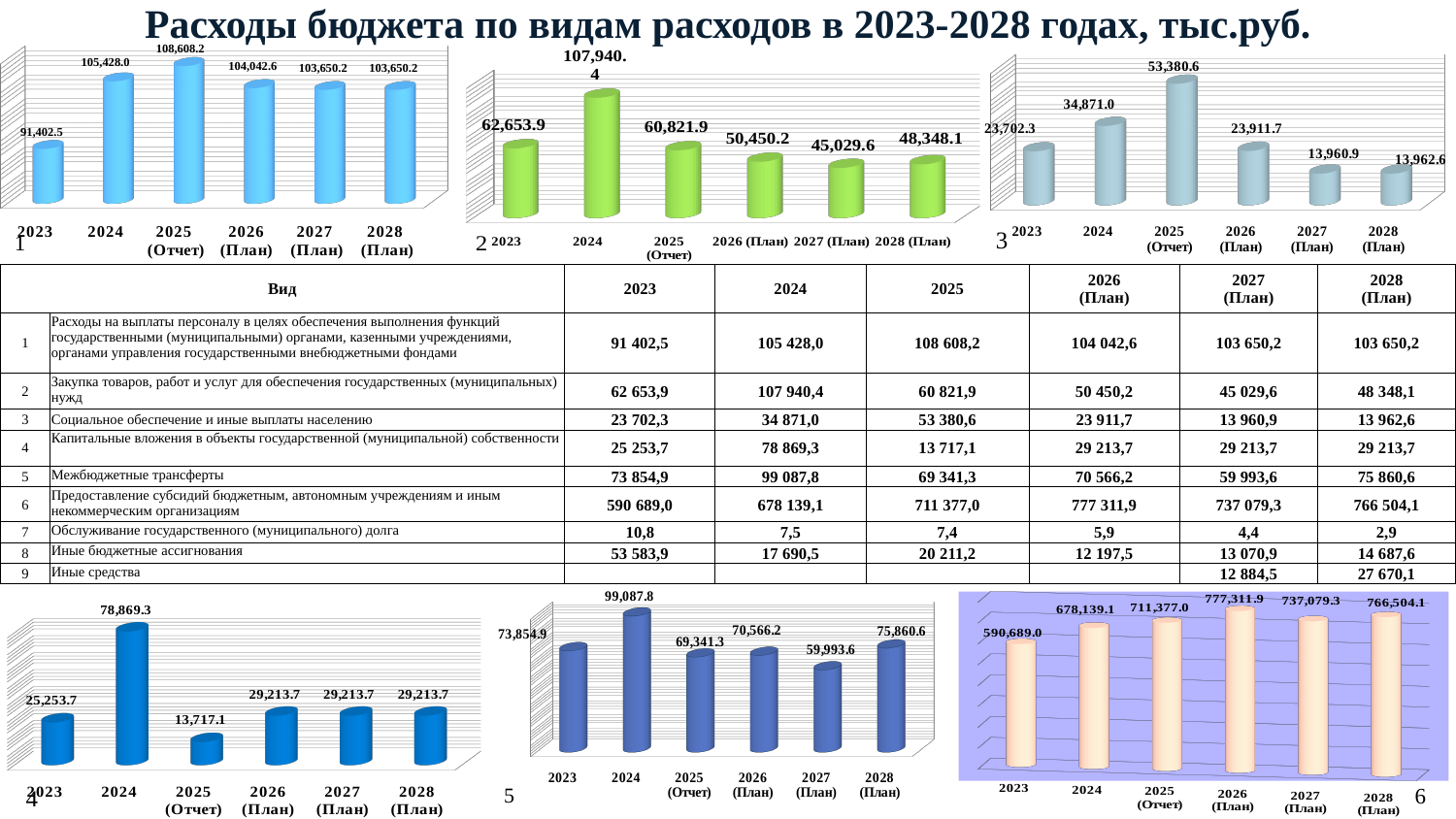
In chart 4 (bottom left), what is the value for 2025 (Отчет)? 13,717.1 How many bars does chart 3 (top right) have? 6 What type of chart is chart 5 (bottom middle)? Bar chart In chart 3 (top right), what is the difference between the 2025 value and the 2024 value? 18,509.6 In chart 2 (top middle), which year has the lowest value? 2027 (План) In chart 2 (top middle), what is the value for 2024? 107,940.4 In chart 5 (bottom middle), what is the value for 2027 (План)? 59,993.6 In chart 6 (bottom right), which year has the lowest value? 2023 In chart 6 (bottom right), what is the value for 2026 (План)? 777,311.9 In chart 4 (bottom left), which is larger, the value for 2024 or the value for 2023? 2024 In chart 1 (top left), which year has the highest value? 2025 (Отчет) In chart 1 (top left), what is the value for 2023? 91,402.5